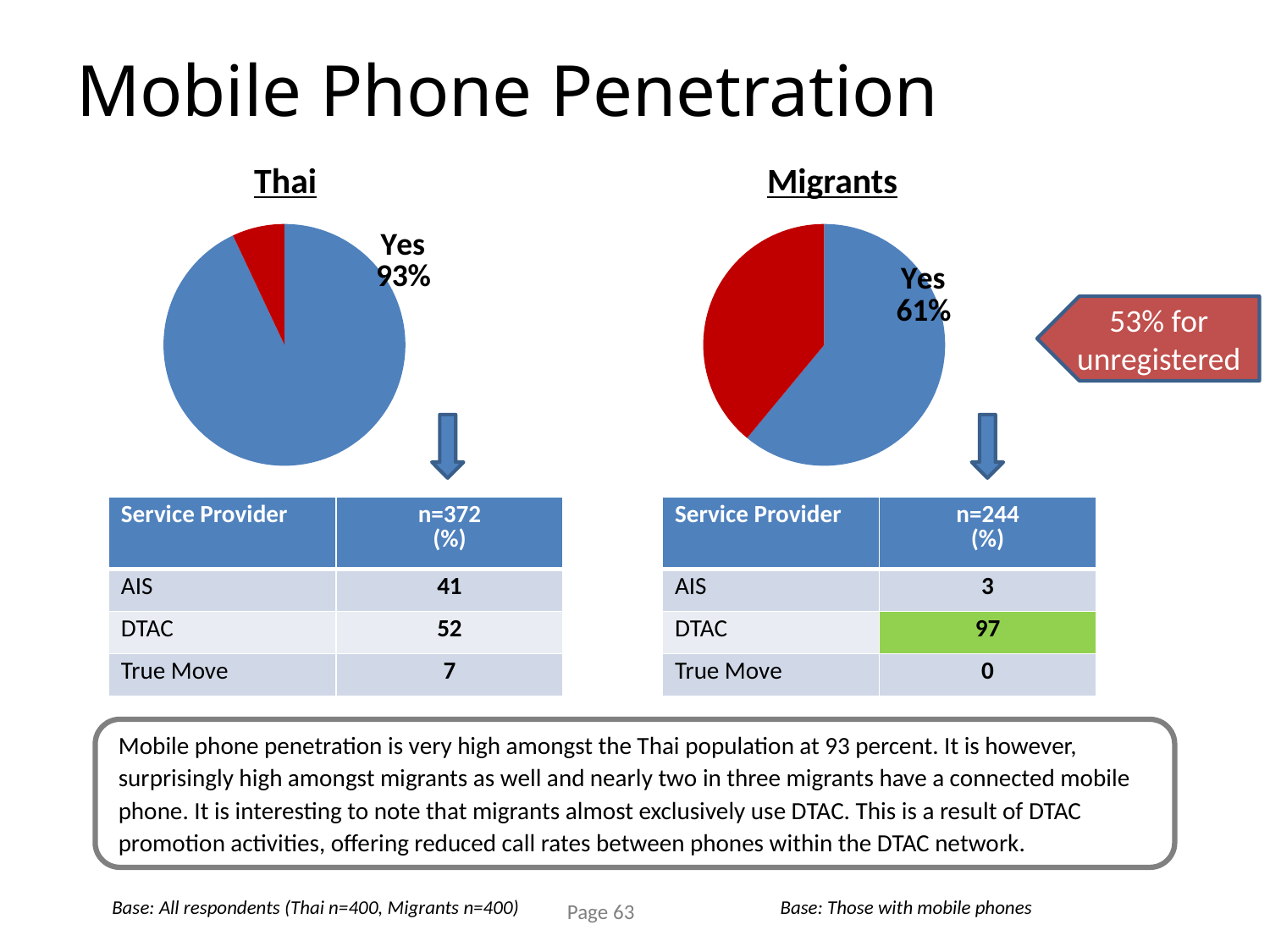
In the Thai pie chart, what percentage is shown for the Yes slice? 93% What kind of chart is used for the Thai and Migrants data? Pie chart In the Thai pie chart, which slice is the largest? Yes In the Migrants pie chart, which slice is larger, the Yes slice or the unlabeled red slice? Yes What is the difference in percentage points between the Yes share in the Thai pie chart and the Yes share in the Migrants pie chart? 32 percentage points How many slices does the Migrants pie chart have? 2 In the Migrants pie chart, is the Yes slice greater or less than 50%? greater What colour is the Yes slice in both pie charts? Blue What is the title above the left pie chart? Thai How many slices does the Thai pie chart have? 2 Which pie chart shows the larger Yes share, Thai or Migrants? Thai In the Migrants pie chart, what percentage is shown for the Yes slice? 61%